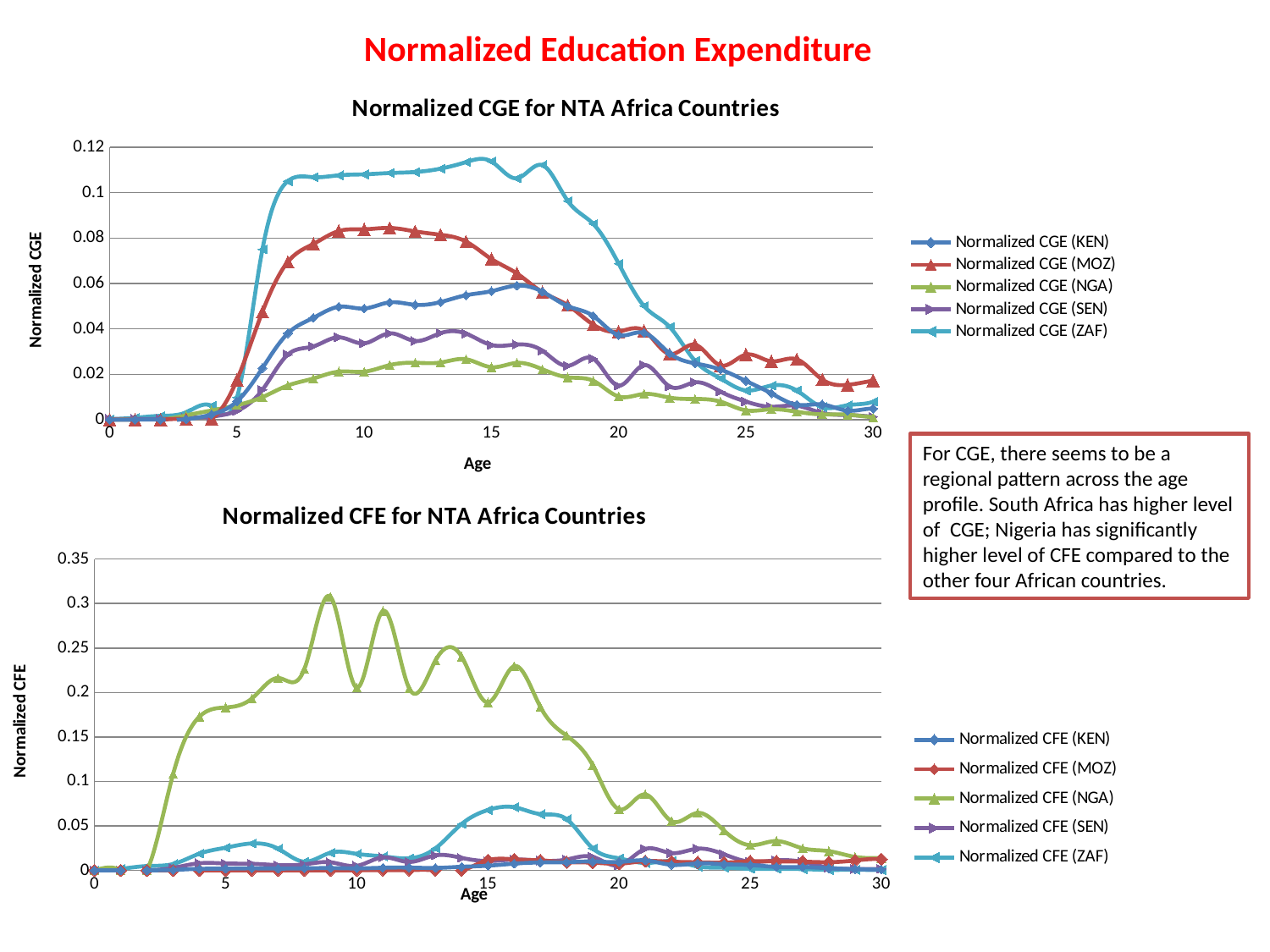
In the 'Normalized CGE for NTA Africa Countries' chart, is the value for Normalized CGE (MOZ) at age 10 greater or less than 0.1? less In the 'Normalized CFE for NTA Africa Countries' chart, is the value for Normalized CFE (NGA) at age 9 greater or less than 0.25? greater In the 'Normalized CGE for NTA Africa Countries' chart, is the value for Normalized CGE (NGA) at age 15 greater or less than 0.04? less How many series does the legend of the 'Normalized CGE for NTA Africa Countries' chart list? 5 What kind of chart is the 'Normalized CGE for NTA Africa Countries' chart? Line chart In the 'Normalized CFE for NTA Africa Countries' chart, which country's series reaches the highest value? Normalized CFE (NGA) What is the x-axis title of the 'Normalized CFE for NTA Africa Countries' chart? Age In the 'Normalized CGE for NTA Africa Countries' chart, does the Normalized CGE (ZAF) series rise or fall from age 17 to age 30? fall In the 'Normalized CGE for NTA Africa Countries' chart, which is larger at age 20: Normalized CGE (ZAF) or Normalized CGE (NGA)? Normalized CGE (ZAF) In the 'Normalized CGE for NTA Africa Countries' chart, which country's series reaches the highest value? Normalized CGE (ZAF)